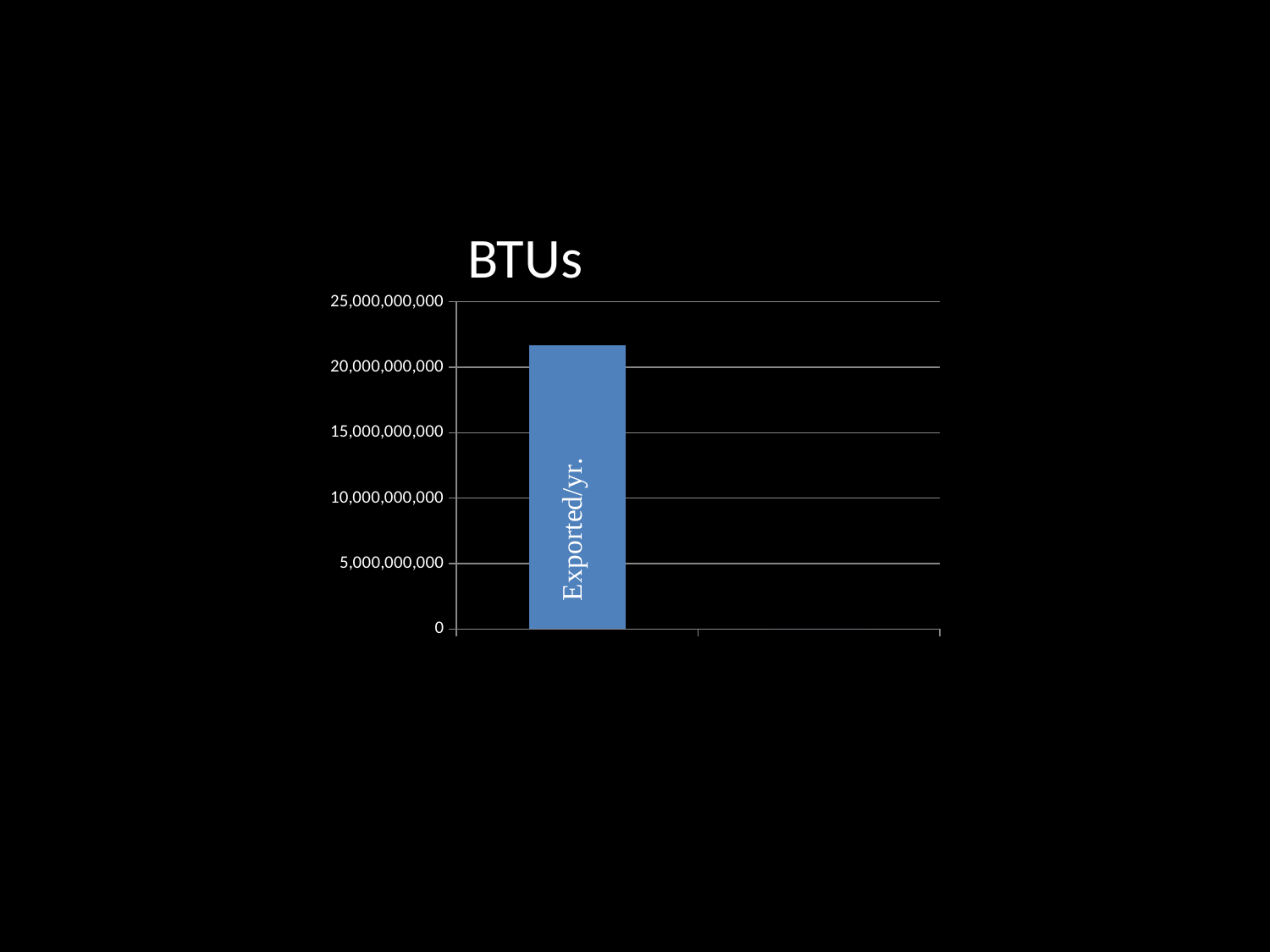
What is the highest value shown on the vertical axis? 25,000,000,000 What label is written on the bar in the chart? Exported/yr. What kind of chart is shown on the slide? bar chart How many bars are plotted in the chart? 1 Is the value for Exported/yr. greater or less than 15,000,000,000? greater Is the value for Exported/yr. greater or less than 25,000,000,000? less What is the lowest value shown on the vertical axis? 0 What is the interval between consecutive tick marks on the vertical axis? 5,000,000,000 Is the value for Exported/yr. greater or less than 20,000,000,000? greater What is the title of the chart? BTUs